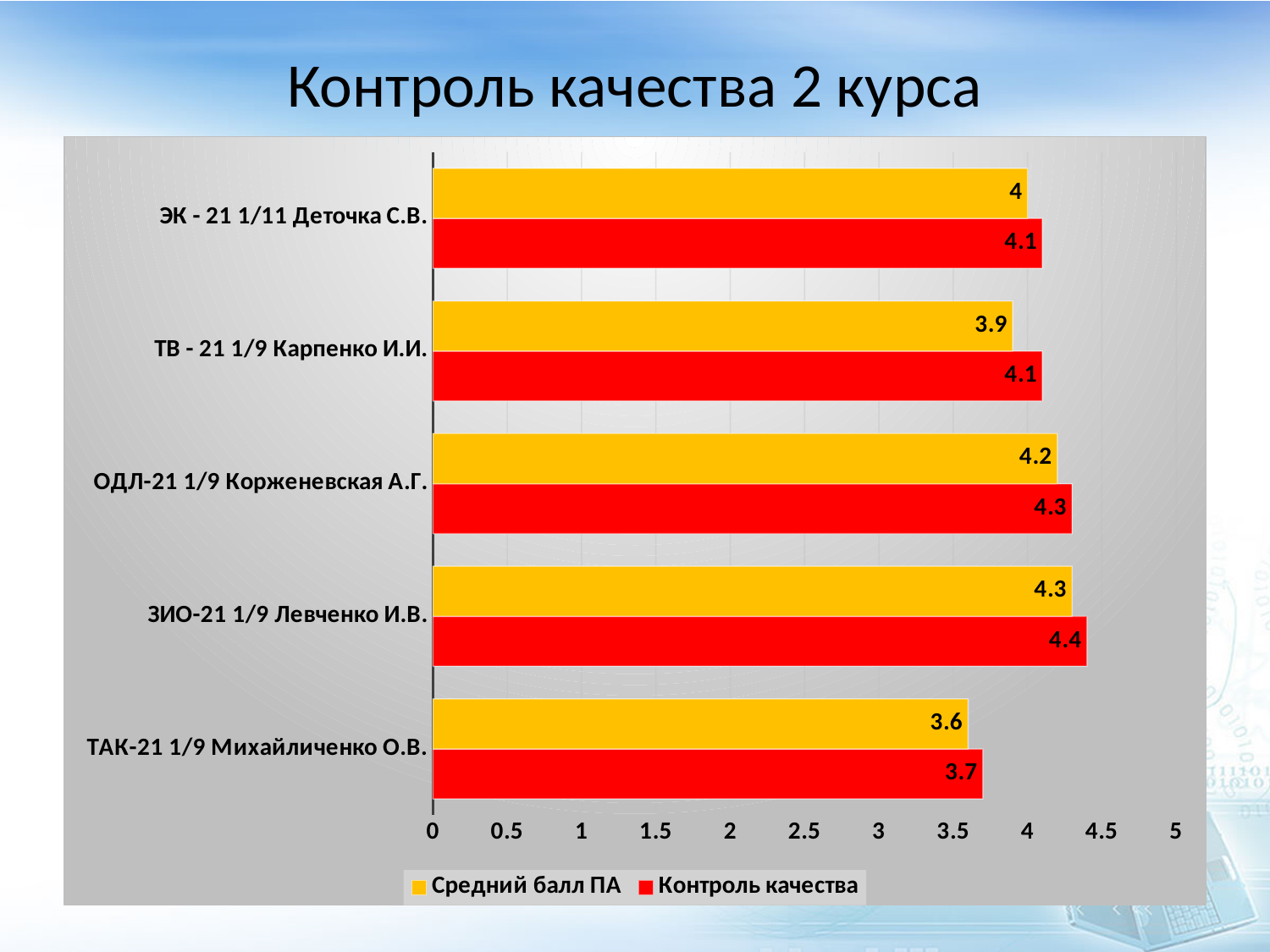
What is the difference between Контроль качества and Средний балл ПА for ОДЛ-21 1/9 Корженевская А.Г.? 0.1 What is the value of Контроль качества for ТВ - 21 1/9 Карпенко И.И.? 4.1 What is the value of Средний балл ПА for ЭК - 21 1/11 Деточка С.В.? 4 Is the Контроль качества value for ТАК-21 1/9 Михайличенко О.В. greater or less than 4? less What kind of chart is shown on the slide? bar chart How many groups are shown on the chart? 5 What is the value of Средний балл ПА for ТАК-21 1/9 Михайличенко О.В.? 3.6 Which is larger for ЗИО-21 1/9 Левченко И.В.: Средний балл ПА or Контроль качества? Контроль качества Which group has the lowest Средний балл ПА value? ТАК-21 1/9 Михайличенко О.В. How many series does the legend list? 2 What is the title of the slide? Контроль качества 2 курса Which group has the highest Контроль качества value? ЗИО-21 1/9 Левченко И.В.